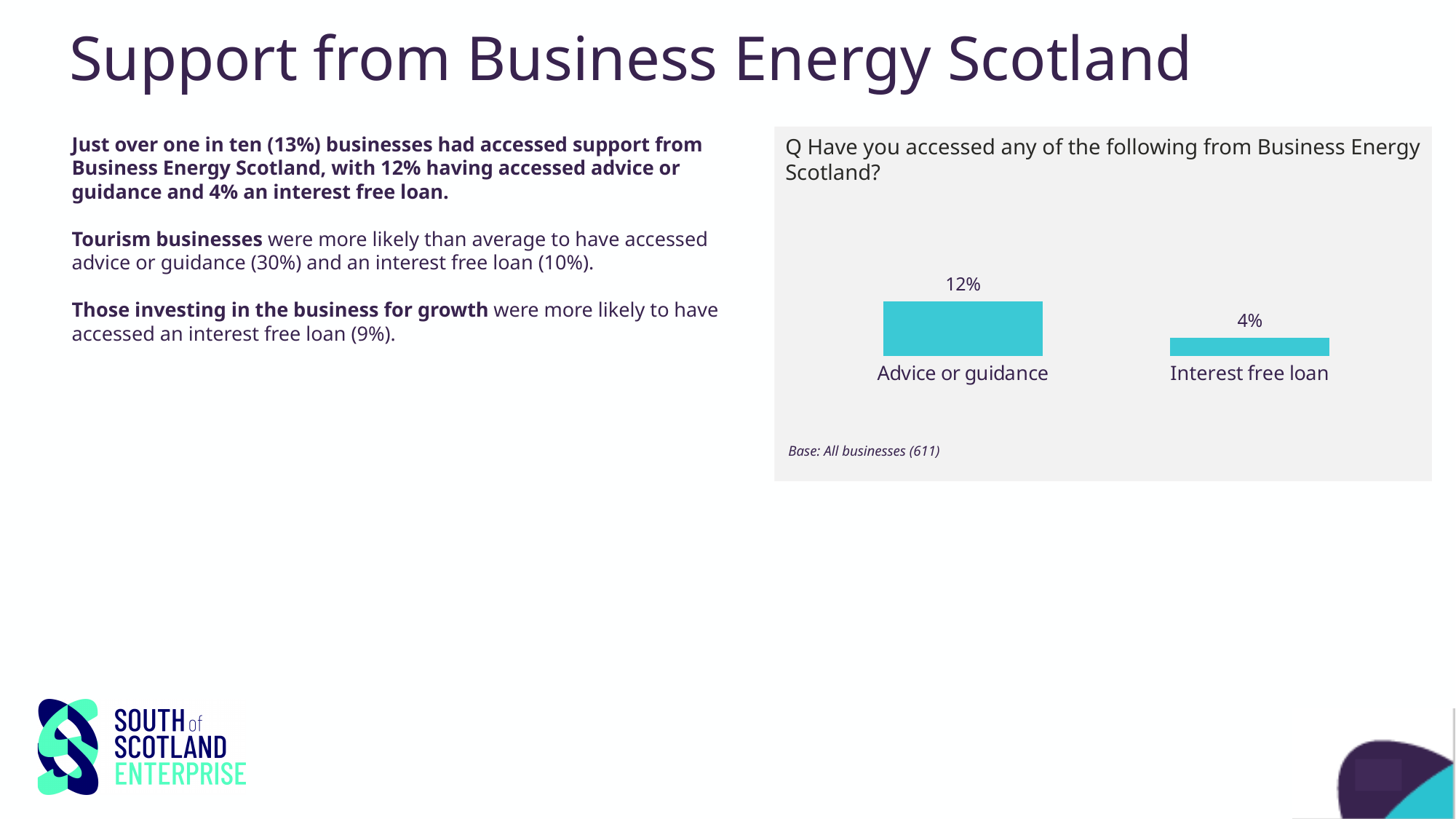
How many categories are shown in the chart? 2 Which is larger, the value for Advice or guidance or the value for Interest free loan? Advice or guidance What is the base (number of respondents) stated for the chart? All businesses (611) What percentage of businesses had accessed an interest free loan from Business Energy Scotland? 4% What is the difference in percentage points between Advice or guidance and Interest free loan? 8 Which category has the highest value in the chart? Advice or guidance What kind of chart is shown on the slide? Bar chart What question does the chart report responses to? Have you accessed any of the following from Business Energy Scotland? What percentage of businesses had accessed advice or guidance from Business Energy Scotland? 12% Which category has the lowest value in the chart? Interest free loan